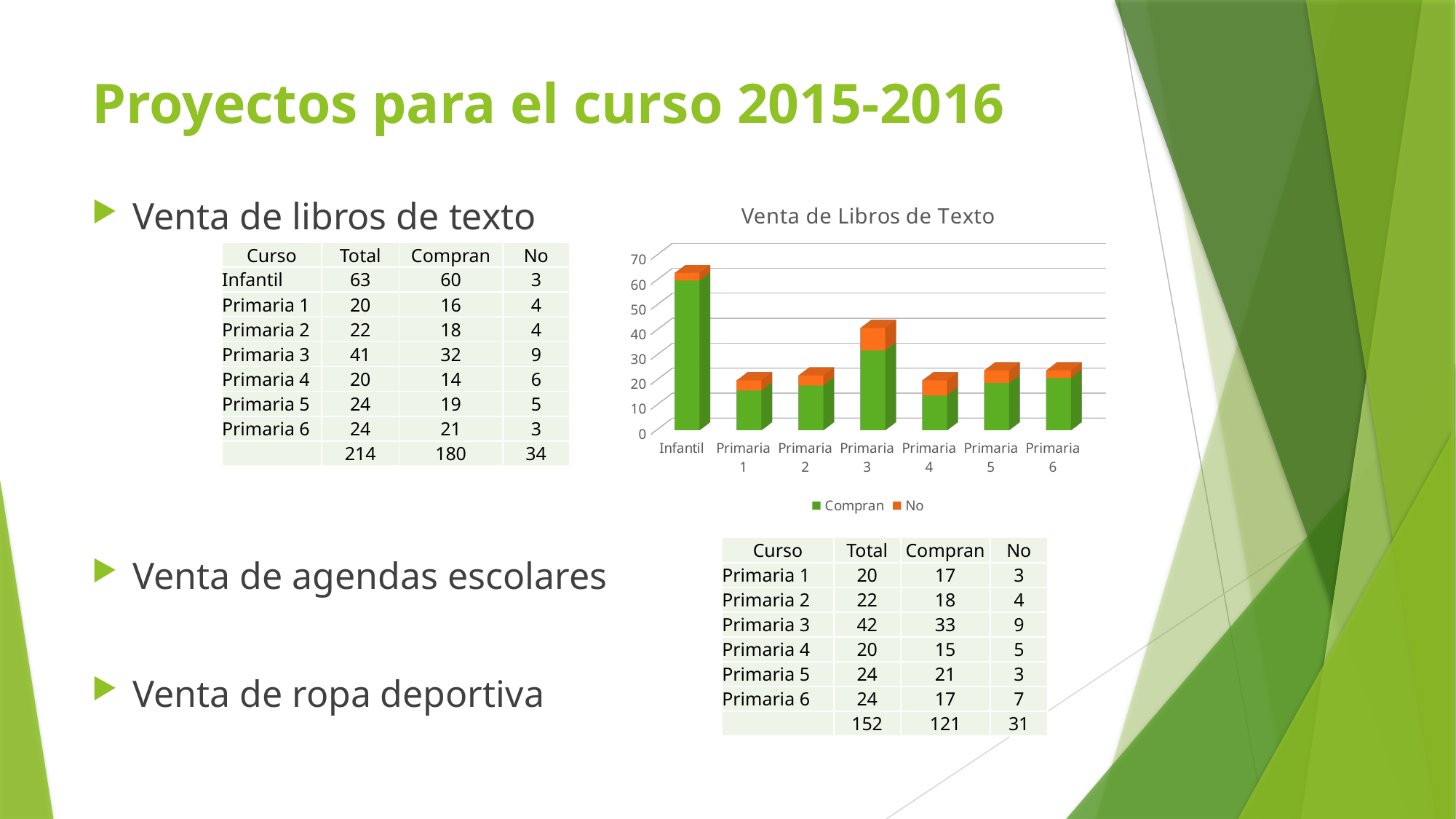
How many series does the legend of the "Venta de Libros de Texto" chart list? 2 How many courses (categories) are shown on the x axis of the "Venta de Libros de Texto" chart? 7 What is the "Compran" value for Infantil in the "Venta de Libros de Texto" chart? 60 In the "Venta de Libros de Texto" chart, is the "Compran" value for Infantil greater or less than 50? greater In the "Venta de Libros de Texto" chart, is the total stacked bar for Primaria 1 greater or less than 30? less Which course has the tallest stacked bar in the "Venta de Libros de Texto" chart? Infantil What is the total of the stacked bar for Infantil in the "Venta de Libros de Texto" chart? 63 What kind of chart is "Venta de Libros de Texto"? bar chart Which course has the largest "No" segment in the "Venta de Libros de Texto" chart? Primaria 3 What colour represents the "Compran" series in the "Venta de Libros de Texto" chart? green In the "Venta de Libros de Texto" chart, which stacked bar is taller: Primaria 3 or Primaria 5? Primaria 3 In the "Venta de Libros de Texto" chart, what is the difference between the "Compran" values for Infantil and Primaria 3? 28